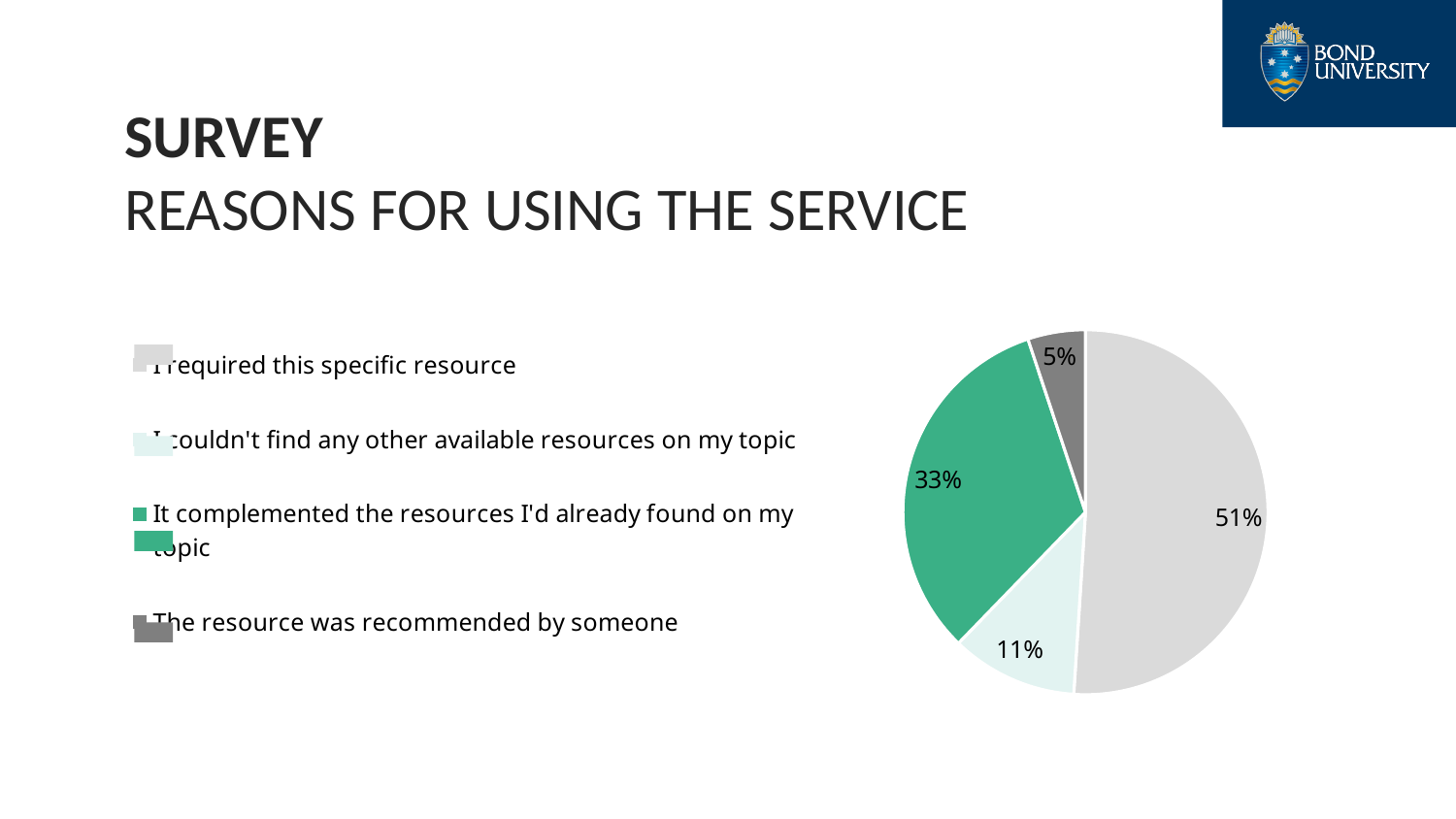
Which is larger: the share for 'I couldn't find any other available resources on my topic' or the share for 'The resource was recommended by someone'? I couldn't find any other available resources on my topic Which reason has the smallest share of the pie? The resource was recommended by someone What share of the pie is 'It complemented the resources I'd already found on my topic'? 33% What kind of chart is shown on the slide? pie chart What share of the pie is 'I couldn't find any other available resources on my topic'? 11% How many slices does the pie chart have? 4 Which legend entry is shown in green? It complemented the resources I'd already found on my topic Which reason has the largest share of the pie? I required this specific resource What is the difference in percentage points between 'I required this specific resource' and 'It complemented the resources I'd already found on my topic'? 18 What share of the pie is 'The resource was recommended by someone'? 5% What share of the pie is 'I required this specific resource'? 51% How many entries does the legend list? 4